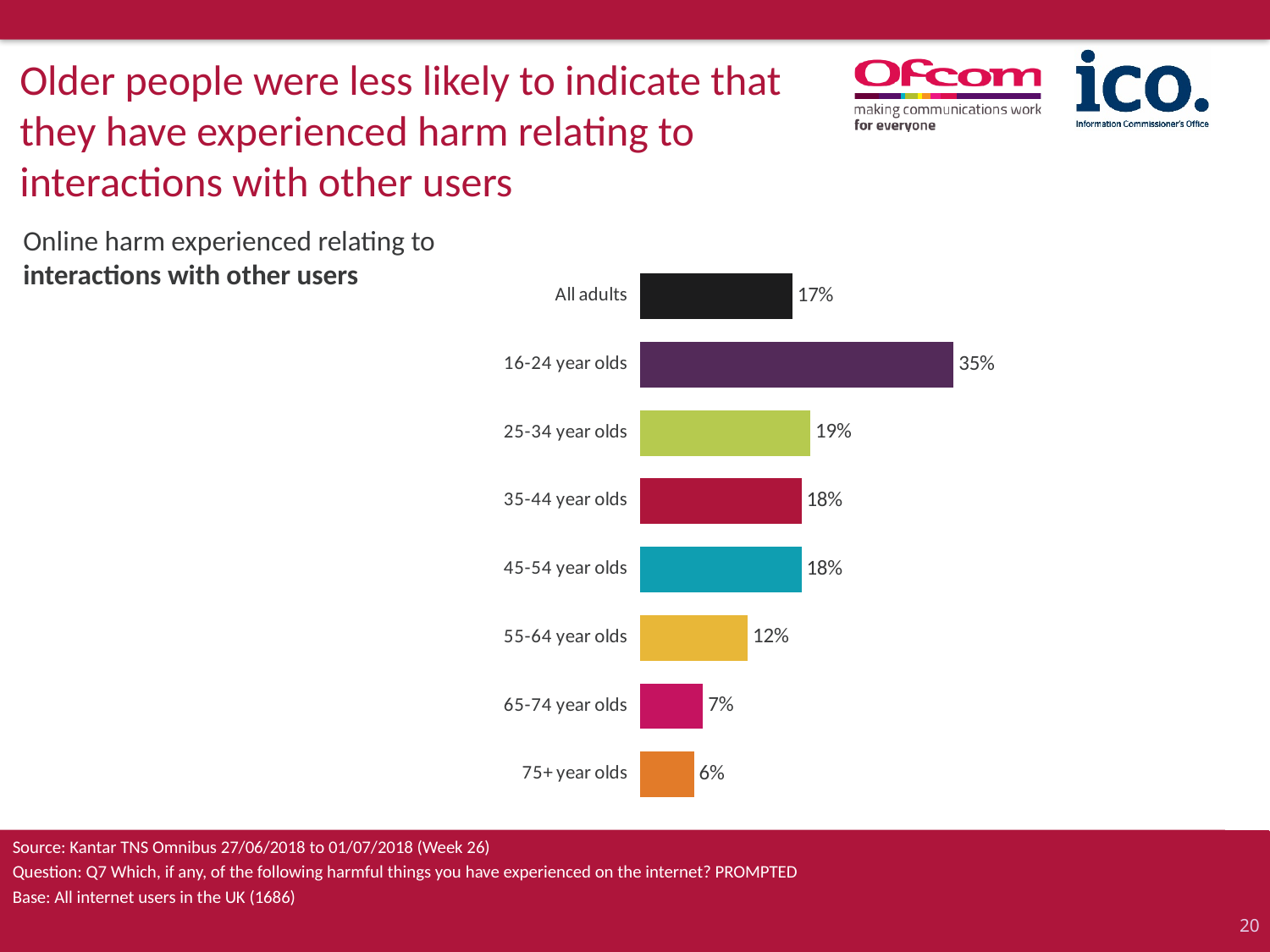
What is the difference between the values for 55-64 year olds and 65-74 year olds? 5% What is the value shown for 16-24 year olds? 35% Which age group has the highest percentage? 16-24 year olds How many categories are shown in the chart? 8 What is the value shown for 55-64 year olds? 12% What is the difference between the values for 16-24 year olds and 25-34 year olds? 16% What kind of chart is shown on the slide? Bar chart Which is larger, the value for 25-34 year olds or the value for 45-54 year olds? 25-34 year olds What is the value shown for 75+ year olds? 6% Do the values generally rise or fall moving from the 16-24 year olds bar down to the 75+ year olds bar? Fall What percentage of all adults experienced online harm relating to interactions with other users? 17% Which category has the lowest percentage? 75+ year olds